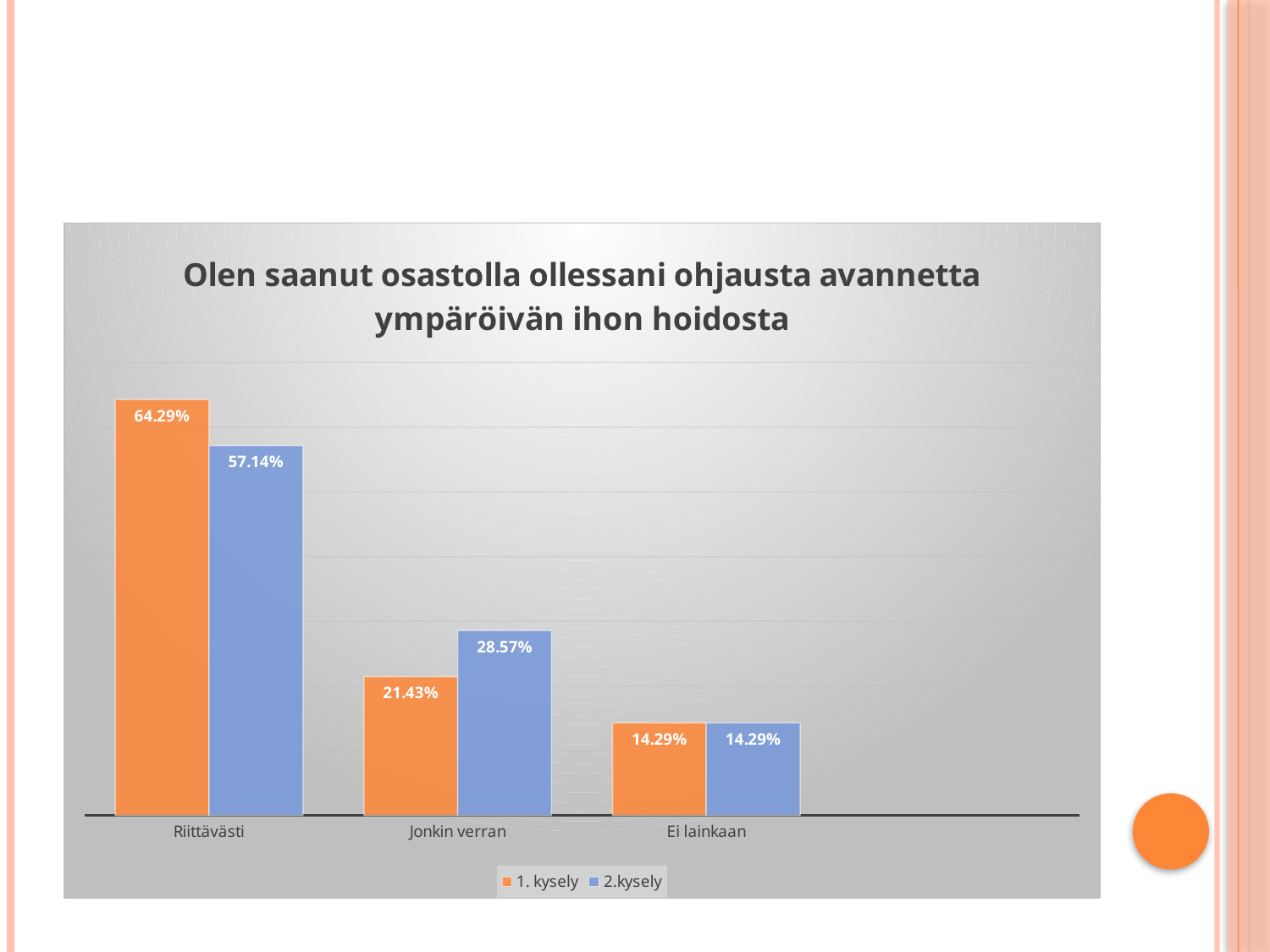
Which category has the lowest value in the 2.kysely series? Ei lainkaan How many categories are shown on the x axis? 3 How many series does the legend list? 2 What is the value for Ei lainkaan in the 1. kysely series? 14.29% What is the value for Riittävästi in the 2.kysely series? 57.14% What is the value for Jonkin verran in the 2.kysely series? 28.57% What kind of chart is shown on the slide? Bar chart Which is larger for Jonkin verran: the 1. kysely value or the 2.kysely value? 2.kysely What is the value for Riittävästi in the 1. kysely series? 64.29% What is the difference between the 2.kysely and 1. kysely values for Jonkin verran? 7.14% What is the difference between the 1. kysely and 2.kysely values for Riittävästi? 7.15% Which category has the highest value in the 1. kysely series? Riittävästi